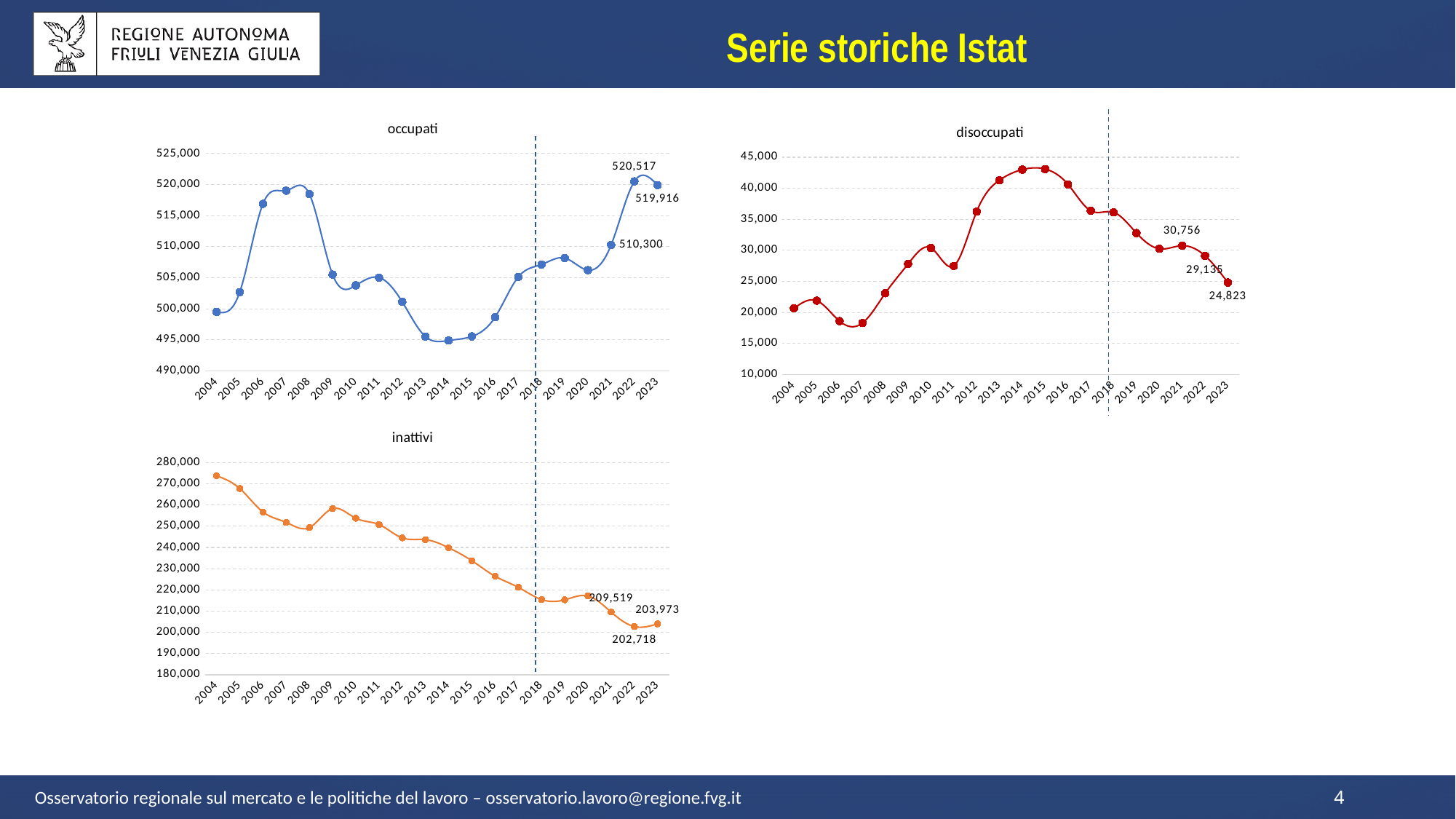
In the 'occupati' chart, which year has the lowest value? 2014 In the 'occupati' chart, what is the value for 2022? 520,517 In the 'disoccupati' chart, is the value for 2014 greater or less than 40,000? greater In the 'inattivi' chart, what is the value for 2022? 202,718 In the 'occupati' chart, what is the difference between the 2022 value and the 2021 value? 10,217 How many years are plotted on the x axis of the 'inattivi' chart? 20 What kind of chart is the 'disoccupati' chart? line chart In the 'disoccupati' chart, what is the value for 2023? 24,823 In the 'occupati' chart, what is the value for 2023? 519,916 In the 'disoccupati' chart, what is the difference between the 2021 value and the 2023 value? 5,933 In the 'inattivi' chart, which is larger, the value for 2021 or the value for 2023? 2021 In the 'inattivi' chart, is the value for 2004 greater or less than 270,000? greater